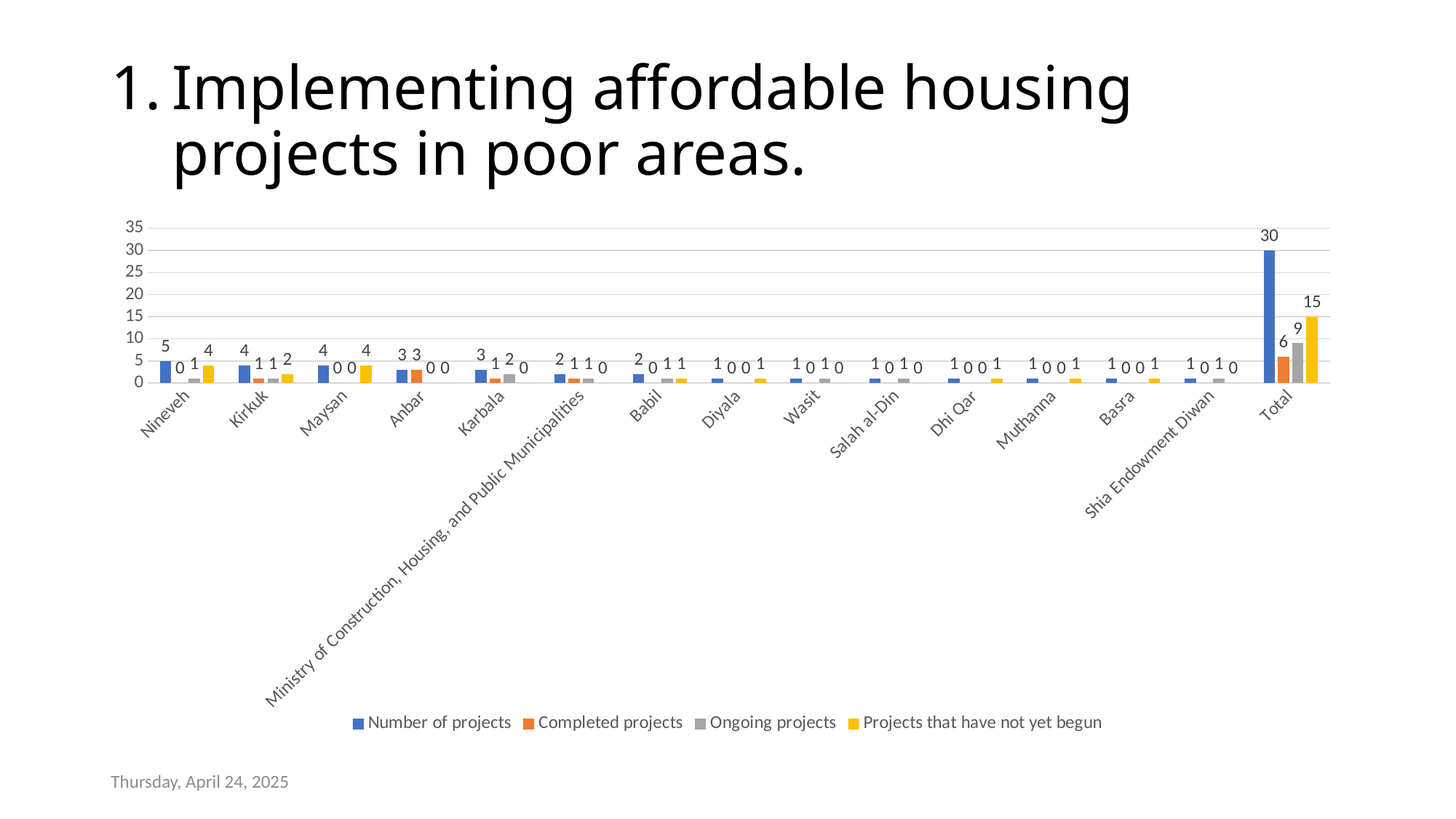
What is the value of Number of projects for Nineveh? 5 How many series does the legend list? 4 What kind of chart is shown on the slide? Bar chart Excluding the Total category, which category has the highest Number of projects? Nineveh Which series is shown in yellow in the legend? Projects that have not yet begun What is the value of Projects that have not yet begun for Total? 15 Which is larger for Kirkuk: Projects that have not yet begun or Completed projects? Projects that have not yet begun How many categories are shown on the x axis? 15 What is the value of Ongoing projects for Karbala? 2 What is the difference between Number of projects and Completed projects for Total? 24 What is the value of Completed projects for Anbar? 3 Is the value of Number of projects for Total greater or less than 25? greater